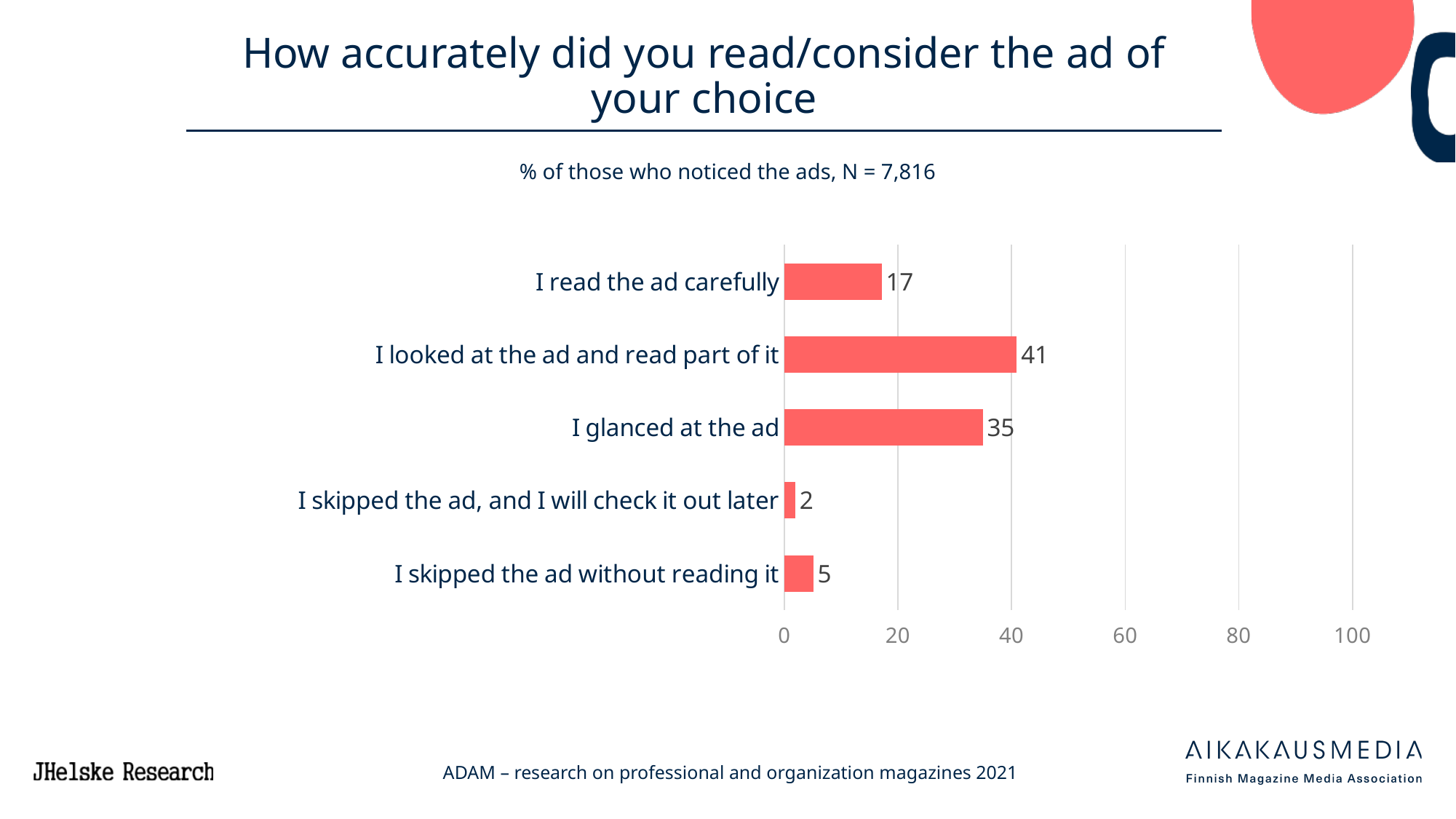
Which category has the lowest value? I skipped the ad, and I will check it out later What is the value for "I skipped the ad, and I will check it out later"? 2 What kind of chart is shown on the slide? bar chart What is the value for "I read the ad carefully"? 17 Is the value for "I glanced at the ad" greater or less than 40? less What is the value for "I looked at the ad and read part of it"? 41 What is the value for "I glanced at the ad"? 35 What is the difference between the values for "I looked at the ad and read part of it" and "I glanced at the ad"? 6 What is the sample size (N) stated in the chart subtitle? 7,816 Which is larger: the value for "I read the ad carefully" or the value for "I skipped the ad without reading it"? I read the ad carefully How many categories are shown in the chart? 5 Which category has the highest value? I looked at the ad and read part of it